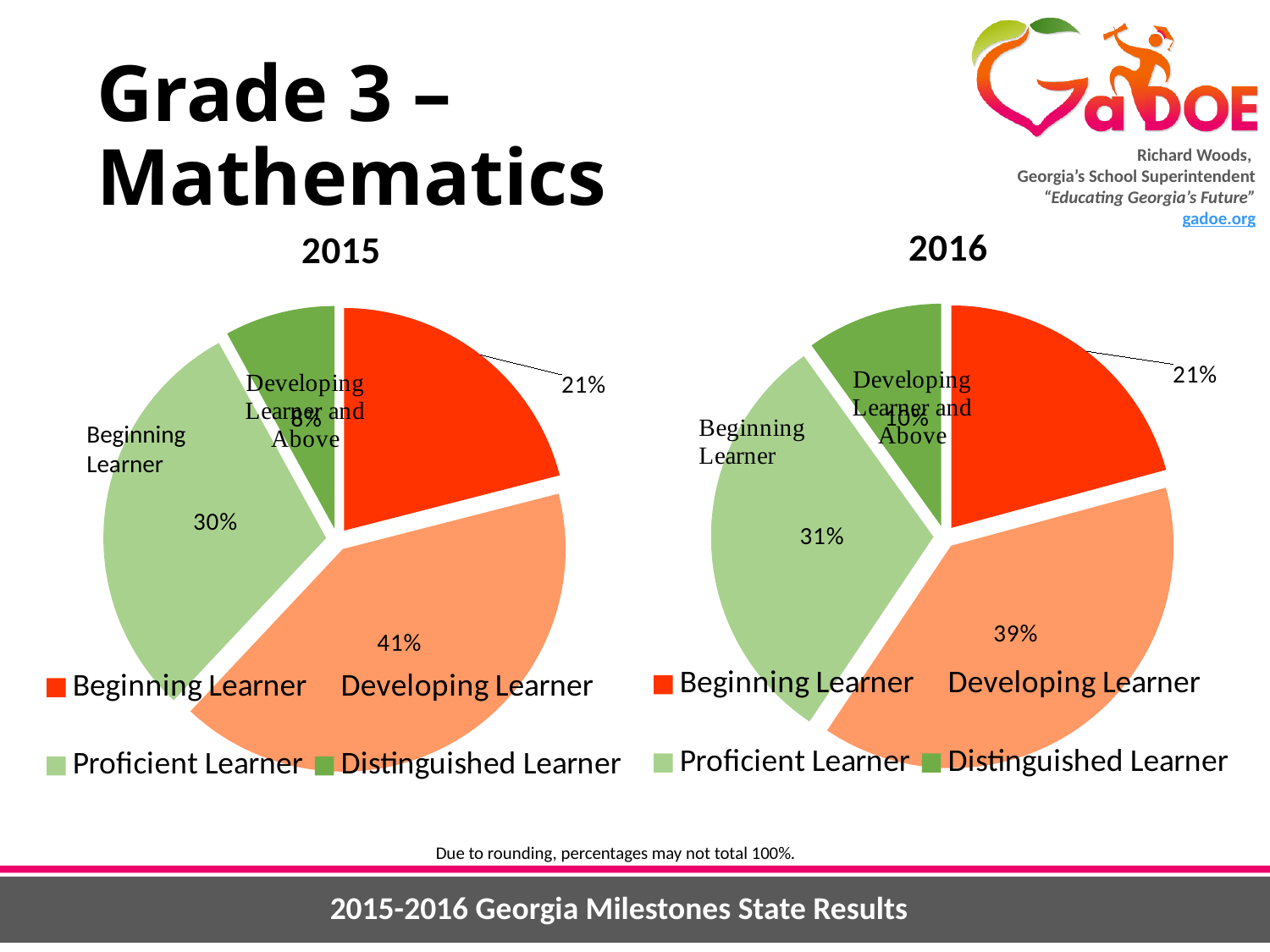
In the 2015 pie chart, which category has the smallest share? Distinguished Learner In the 2015 pie chart, what percentage of students were Distinguished Learners? 8% What type of chart is used to show the 2015 results? Pie chart What is the title of the chart on the right? 2016 In the 2015 pie chart, what colour is the Beginning Learner slice? Red In the 2015 pie chart, what percentage of students were Developing Learners? 41% In the 2016 pie chart, which category has the largest share? Developing Learner In the 2016 pie chart, what percentage of students were Proficient Learners? 31% What is the difference between the Developing Learner percentage in 2015 and in 2016? 2% Which is larger: the Proficient Learner share in 2015 or in 2016? 2016 In the 2016 pie chart, what percentage of students were Beginning Learners? 21% How many categories does the 2016 pie chart show? 4